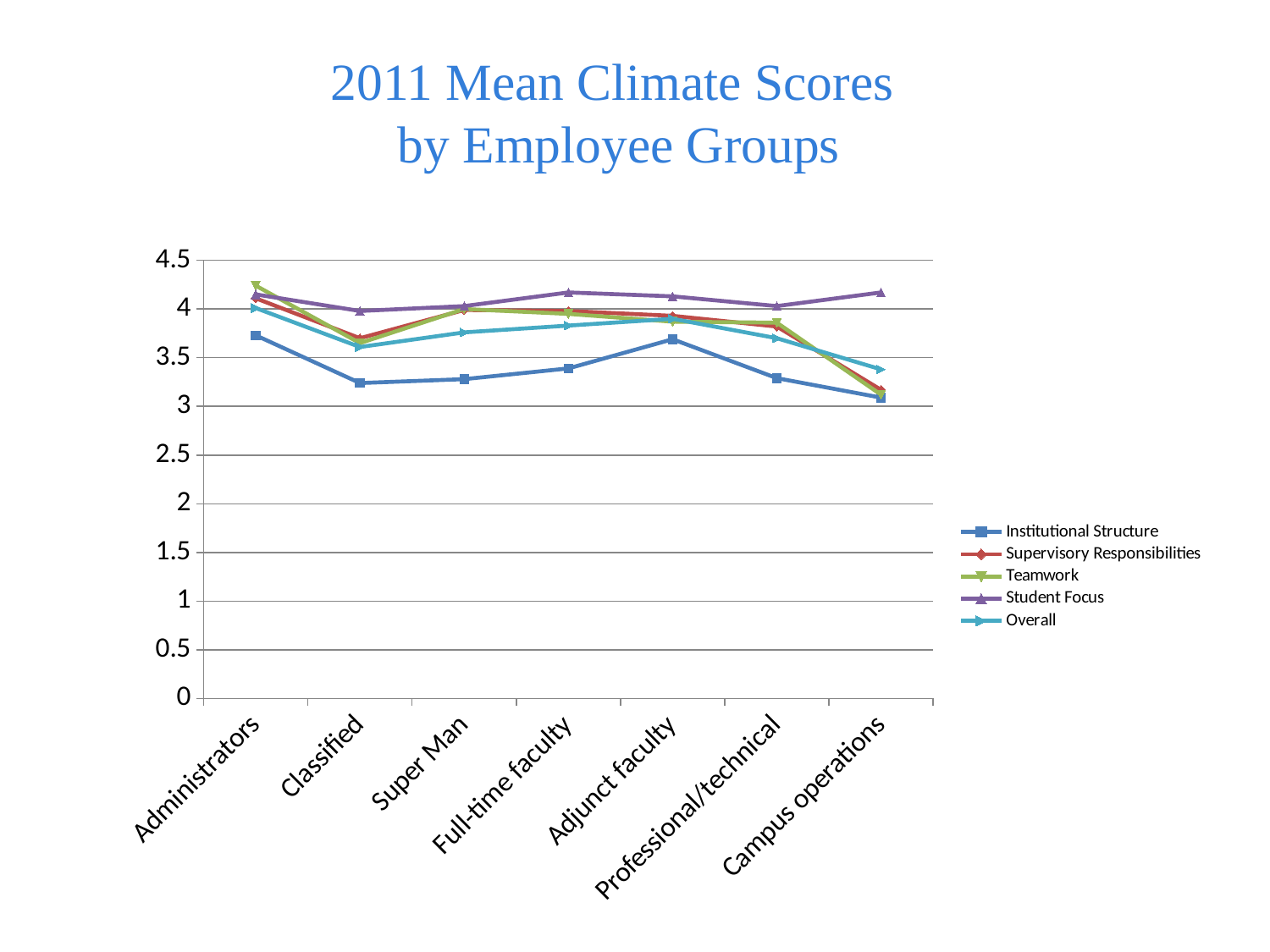
Is the Student Focus value for Campus operations greater or less than 4? greater Is the Institutional Structure value for Classified greater or less than 3.5? less How many employee groups are shown on the x axis? 7 For Adjunct faculty, which is larger: Student Focus or Institutional Structure? Student Focus Is the Institutional Structure value for Administrators greater or less than 3.5? greater For which employee group is the Institutional Structure score lowest? Campus operations What kind of chart is shown on the slide? line chart Which series has the highest value for Campus operations? Student Focus How many series does the legend list? 5 What is the title of the chart? 2011 Mean Climate Scores by Employee Groups